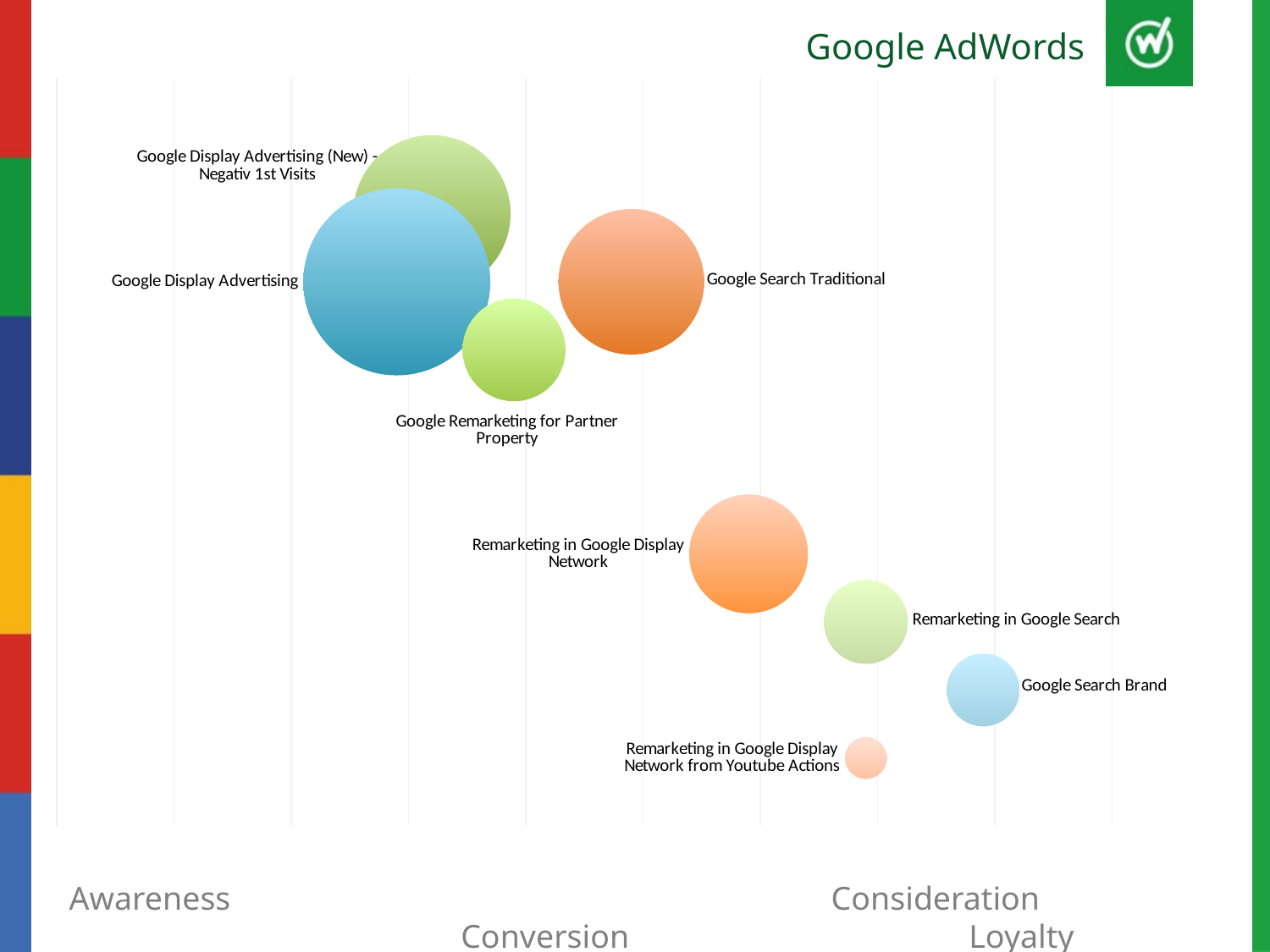
Which bubble is larger, Google Display Advertising or Google Remarketing for Partner Property? Google Display Advertising Which bubble is positioned highest on the chart? Google Display Advertising (New) - Negativ 1st Visits Which bubble is positioned lowest on the chart? Remarketing in Google Display Network from Youtube Actions Which bubble is the largest on the chart? Google Display Advertising Which bubble is the smallest on the chart? Remarketing in Google Display Network from Youtube Actions Which bubble is positioned furthest to the right on the chart? Google Search Brand Which bubble is larger, Remarketing in Google Display Network or Remarketing in Google Search? Remarketing in Google Display Network How many bubbles are plotted on the chart? 8 Moving from left to right across the chart, do the bubbles generally sit higher or lower? Lower What is the title of the chart? Google AdWords Which bubble is larger, Google Search Traditional or Google Search Brand? Google Search Traditional What kind of chart is shown on the slide? Bubble chart